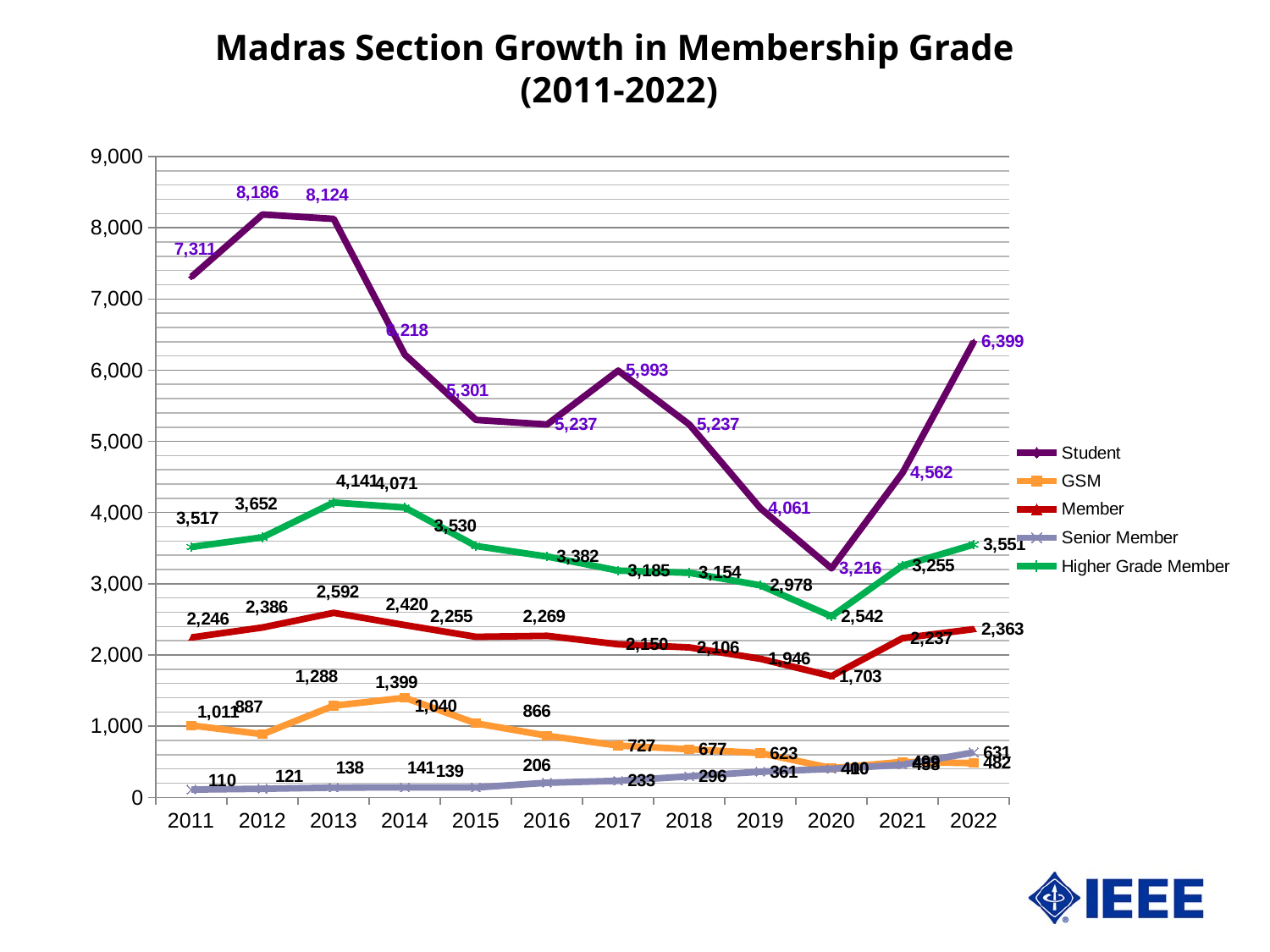
In 2022, which was larger: GSM or Senior Member? Senior Member What was the Higher Grade Member count in 2013? 4,141 In which year was the Student membership highest? 2012 How many series does the legend list? 5 How many years are plotted along the x axis? 12 In which year was the Student membership lowest? 2020 What was the Student membership count in 2012? 8,186 What was the GSM count in 2014? 1,399 What kind of chart is shown on the slide? line chart Does the Senior Member series generally rise or fall from 2011 to 2022? rise What was the Member count in 2020? 1,703 By how much did the Student membership increase from 2021 to 2022? 1,837